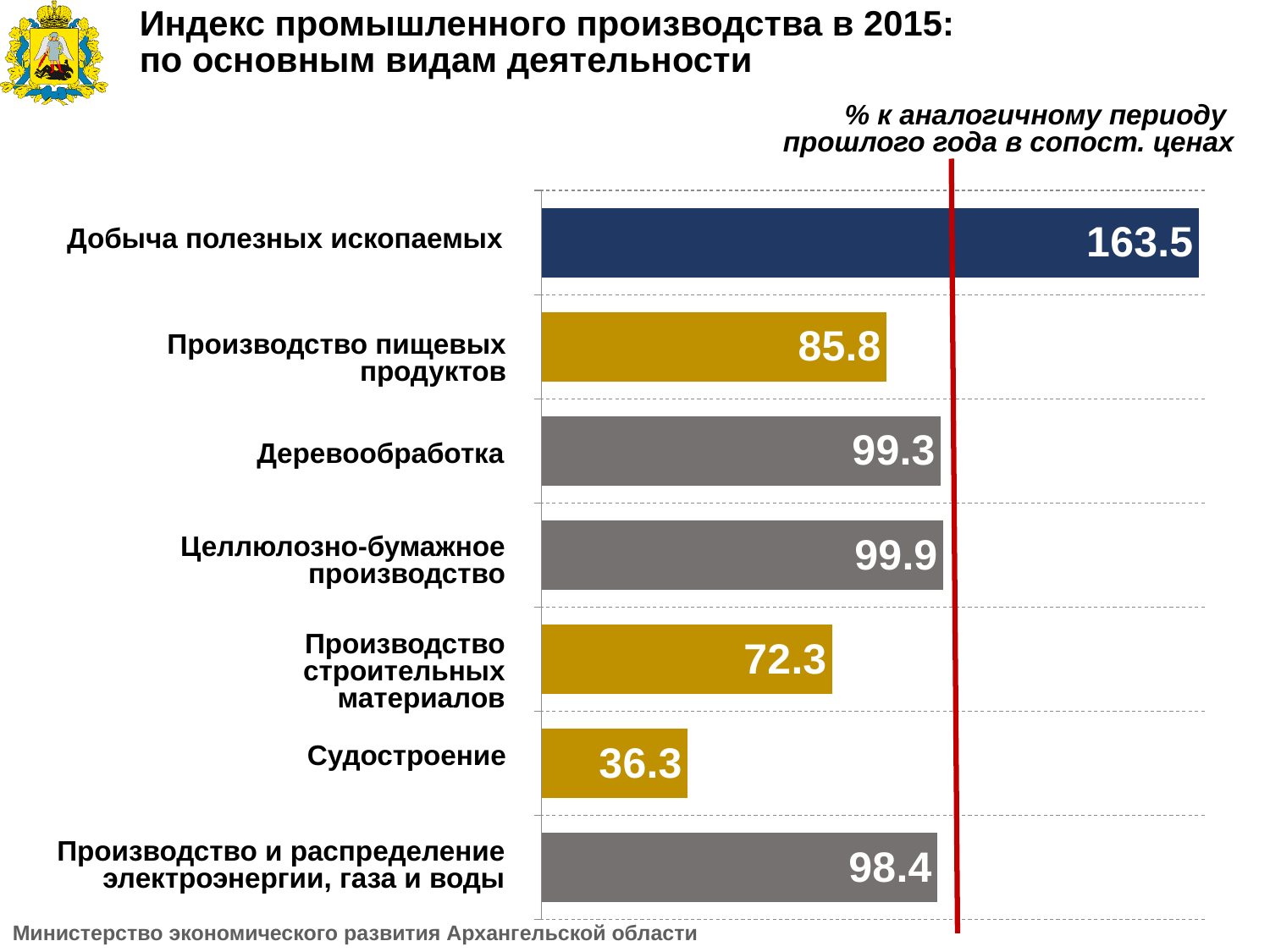
What is the value for Судостроение? 36.3 Which is larger, the value for Деревообработка or the value for Производство пищевых продуктов? Деревообработка What is the difference between the values for Добыча полезных ископаемых and Судостроение? 127.2 What is the value for Производство и распределение электроэнергии, газа и воды? 98.4 What kind of chart is shown on the slide? Bar chart What is the value for Производство строительных материалов? 72.3 Which category has the highest value? Добыча полезных ископаемых What is the difference between the values for Производство пищевых продуктов and Производство строительных материалов? 13.5 How many categories are shown in the chart? 7 What is the value for Добыча полезных ископаемых? 163.5 Which category has the lowest value? Судостроение What is the value for Целлюлозно-бумажное производство? 99.9